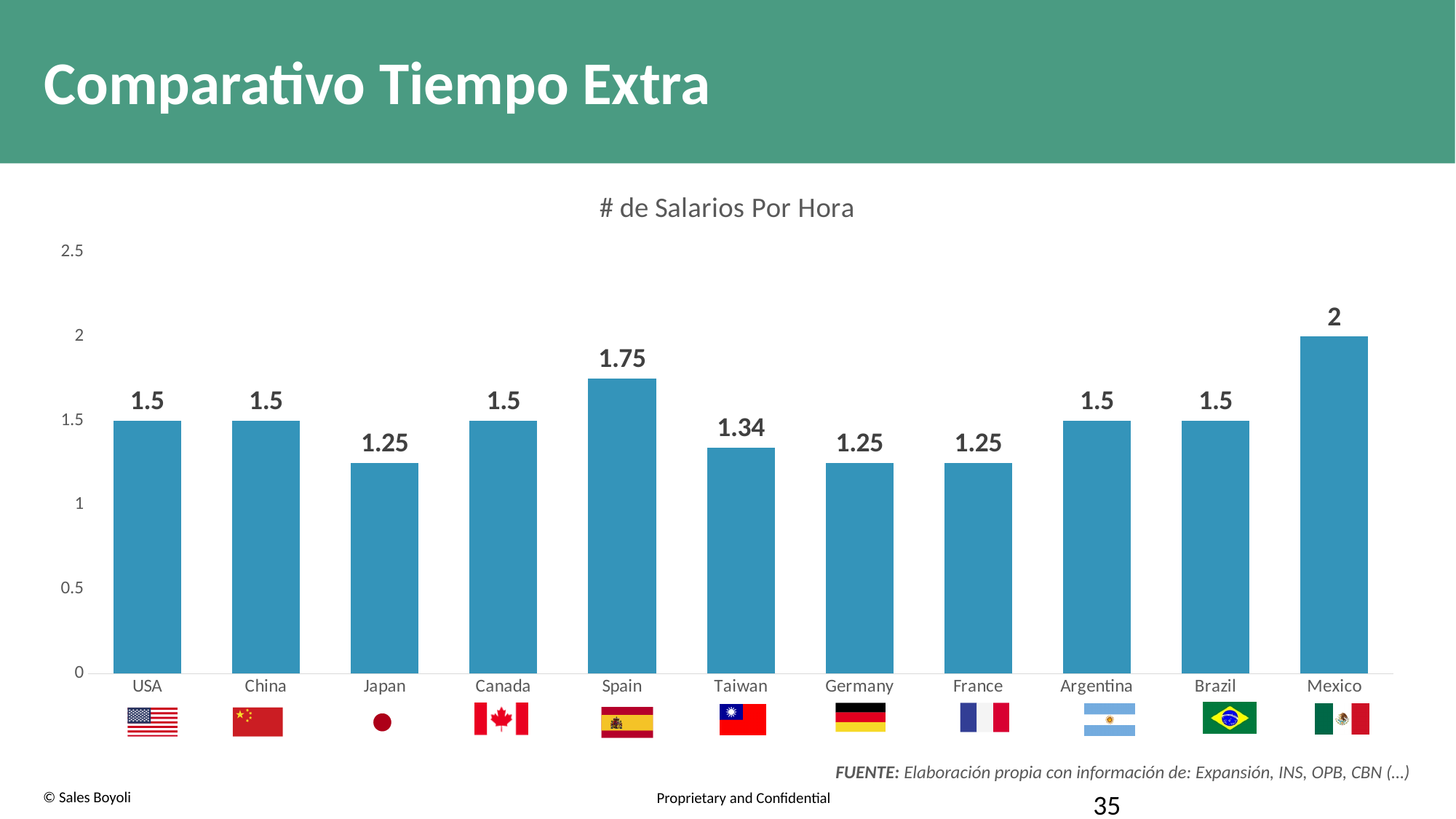
What is the value for Mexico? 2 What is the value for Taiwan? 1.34 Which is larger, the value for Spain or the value for Canada? Spain How many countries are shown on the chart? 11 What kind of chart is shown on the slide? Bar chart Is the value for Mexico greater or less than 1.5? greater What is the title of the chart? # de Salarios Por Hora What is the difference between the values for Taiwan and Japan? 0.09 What is the value for Germany? 1.25 Which country has the highest value? Mexico What is the value for Spain? 1.75 What is the difference between the values for Mexico and Spain? 0.25